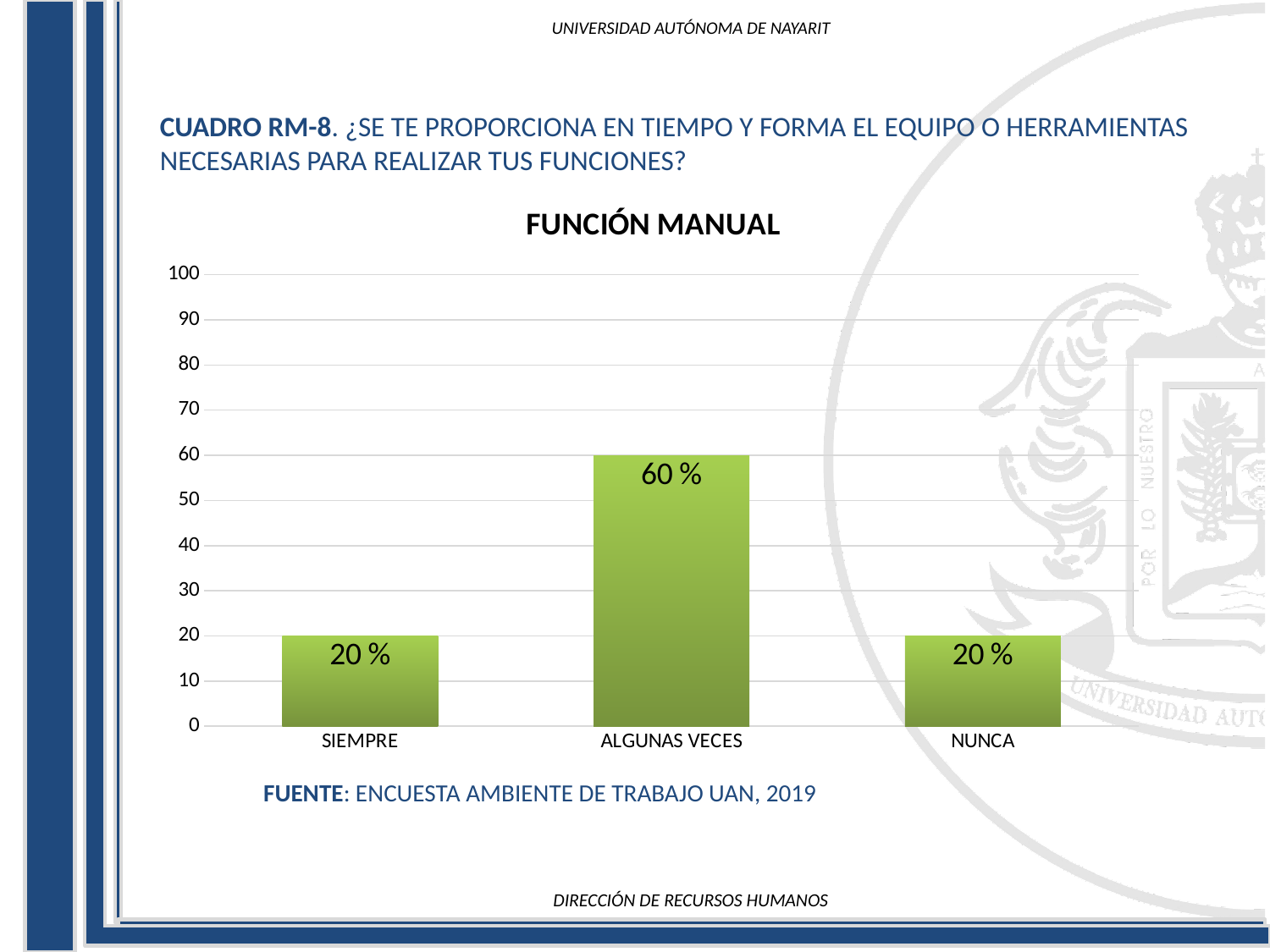
Is the value for ALGUNAS VECES greater or less than 50? greater What is the value for NUNCA? 20 % What is the value for ALGUNAS VECES? 60 % What is the title of the chart? FUNCIÓN MANUAL Which category has the highest value? ALGUNAS VECES What is the value for SIEMPRE? 20 % Which is larger, the value for ALGUNAS VECES or the value for NUNCA? ALGUNAS VECES What is the difference between the values for ALGUNAS VECES and SIEMPRE? 40 % How many categories are shown on the x axis? 3 Is the value for SIEMPRE greater or less than 30? less What is the maximum value shown on the y axis? 100 What kind of chart is shown on the slide? bar chart